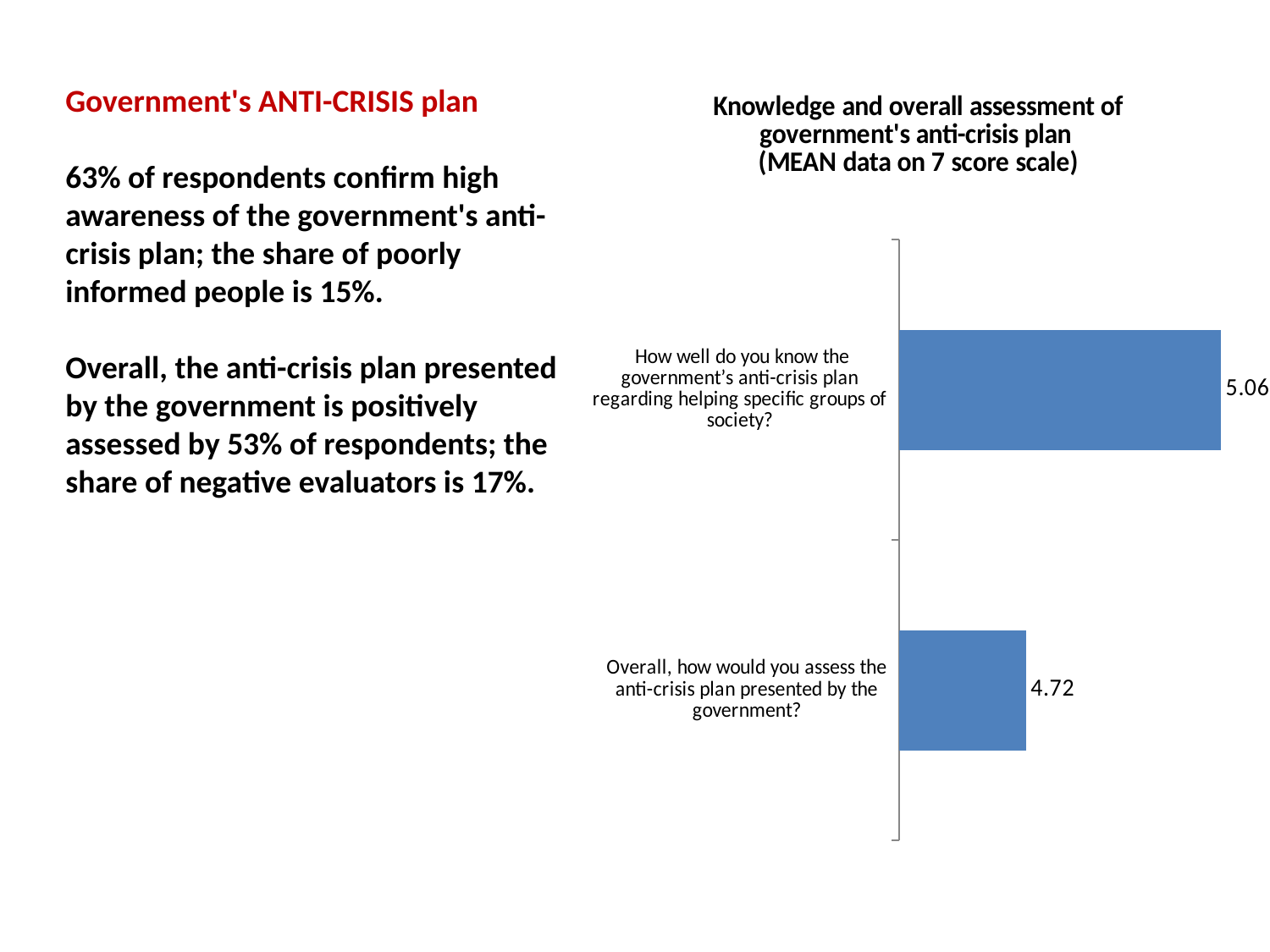
Which question has the higher mean score? How well do you know the government's anti-crisis plan regarding helping specific groups of society? What is the difference between the two mean scores shown in the chart? 0.34 On what scale are the mean scores in the chart measured? 7 score scale How many categories (questions) are plotted in the chart? 2 What is the title of the chart? Knowledge and overall assessment of government's anti-crisis plan (MEAN data on 7 score scale) Is the mean score for knowledge of the anti-crisis plan larger or smaller than the mean score for overall assessment of the plan? larger What is the mean score for 'Overall, how would you assess the anti-crisis plan presented by the government?' 4.72 Which question has the lower mean score? Overall, how would you assess the anti-crisis plan presented by the government? What type of chart is shown on the slide? bar chart What is the mean score for 'How well do you know the government's anti-crisis plan regarding helping specific groups of society?' 5.06